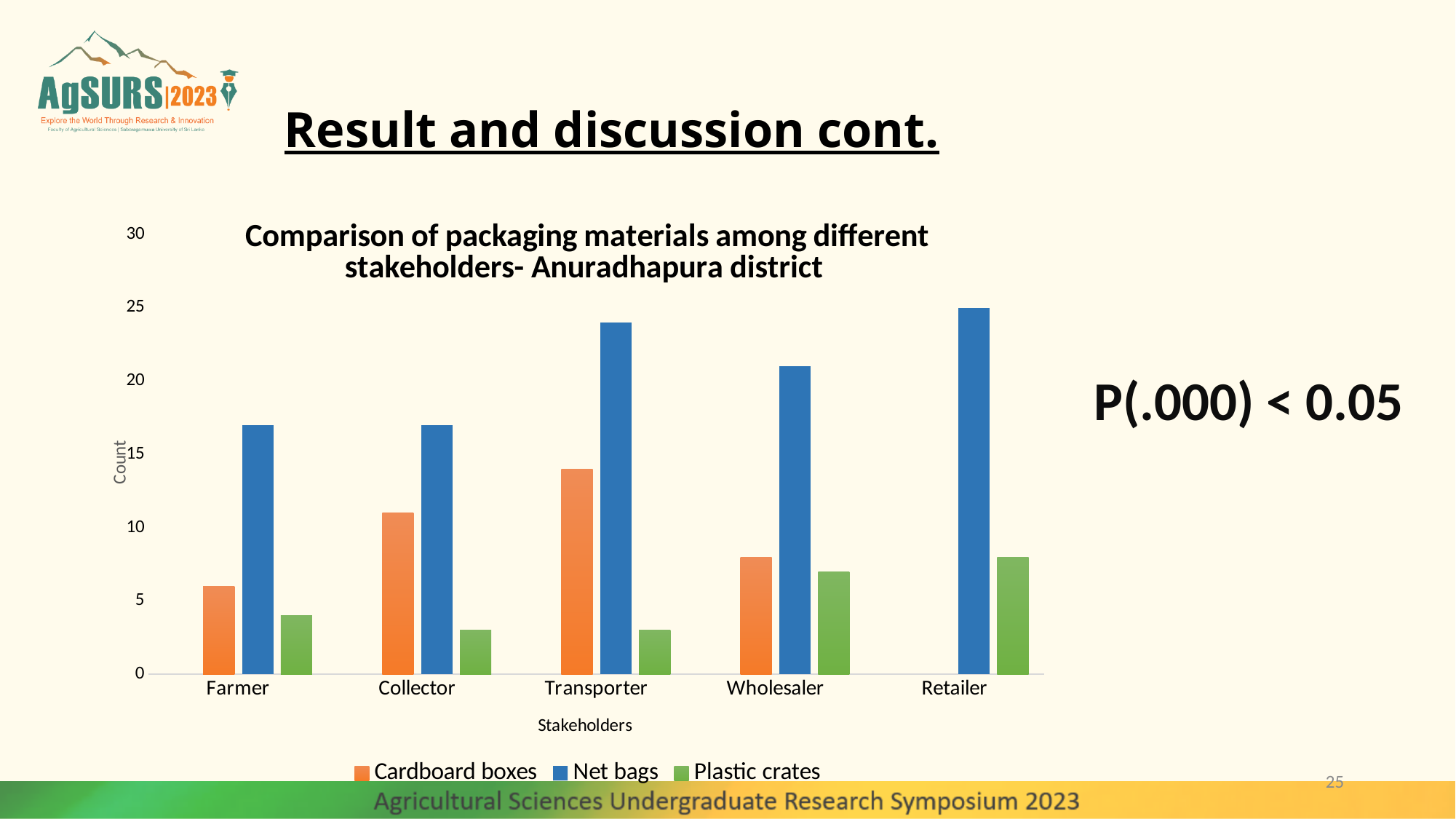
What is the label on the y axis of the chart? Count Is the Plastic crates value for Farmer greater or less than 5? less Is the Net bags value for Wholesaler greater or less than 20? greater Is the Net bags value for Transporter greater or less than 20? greater Which stakeholder has the highest value for Cardboard boxes? Transporter For Farmer, which is larger: Cardboard boxes or Net bags? Net bags How many stakeholder categories are shown on the x axis? 5 How many series does the legend list? 3 What kind of chart is shown on the slide? bar chart Which is larger: Cardboard boxes for Transporter or Cardboard boxes for Wholesaler? Transporter